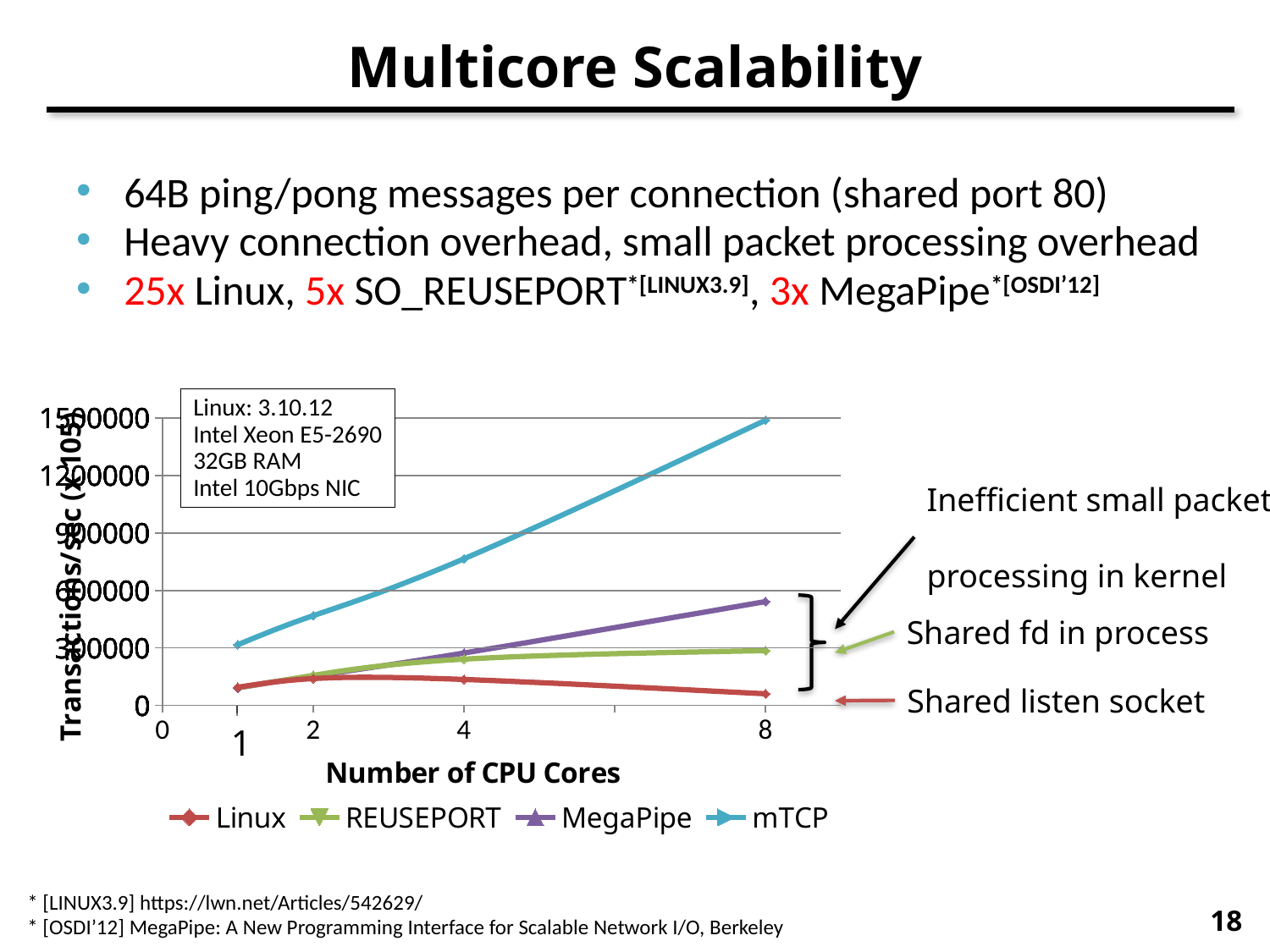
Which series has the highest transactions/sec at 8 CPU cores? mTCP Is the Linux value at 8 CPU cores greater or less than 300000? less What kind of chart is shown on the slide? line chart At 8 CPU cores, which is larger: the MegaPipe value or the REUSEPORT value? MegaPipe Which series has the lowest transactions/sec at 8 CPU cores? Linux Does the mTCP series rise or fall as the number of CPU cores increases? rise Is the MegaPipe value at 8 CPU cores greater or less than 600000? less How many series does the chart legend list? 4 Does the Linux series rise or fall from 2 to 8 CPU cores? fall Is the mTCP value at 2 CPU cores greater or less than 300000? greater What is the label of the x axis of the chart? Number of CPU Cores